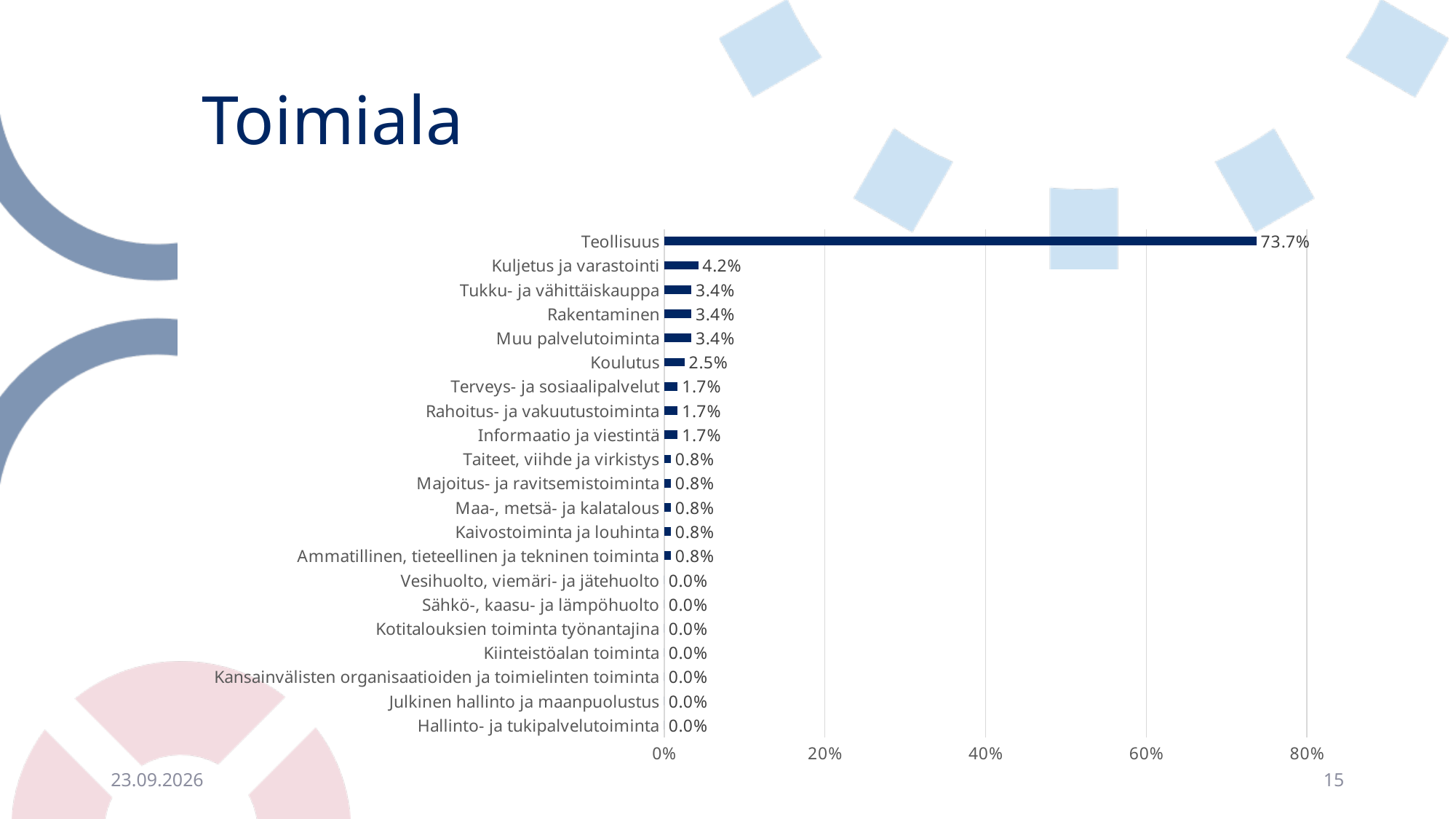
What is the difference between the values for Rakentaminen and Koulutus? 0.9% What is the value for Teollisuus? 73.7% What is the value for Kaivostoiminta ja louhinta? 0.8% Which is larger, the value for Kuljetus ja varastointi or the value for Terveys- ja sosiaalipalvelut? Kuljetus ja varastointi What type of chart is shown on the slide? bar chart What is the difference between the values for Teollisuus and Kuljetus ja varastointi? 69.5% How many categories are shown in the chart? 21 Is the value for Teollisuus greater or less than 60%? greater What is the value for Koulutus? 2.5% Which category has the highest value? Teollisuus What is the value for Kuljetus ja varastointi? 4.2% What is the value for Informaatio ja viestintä? 1.7%